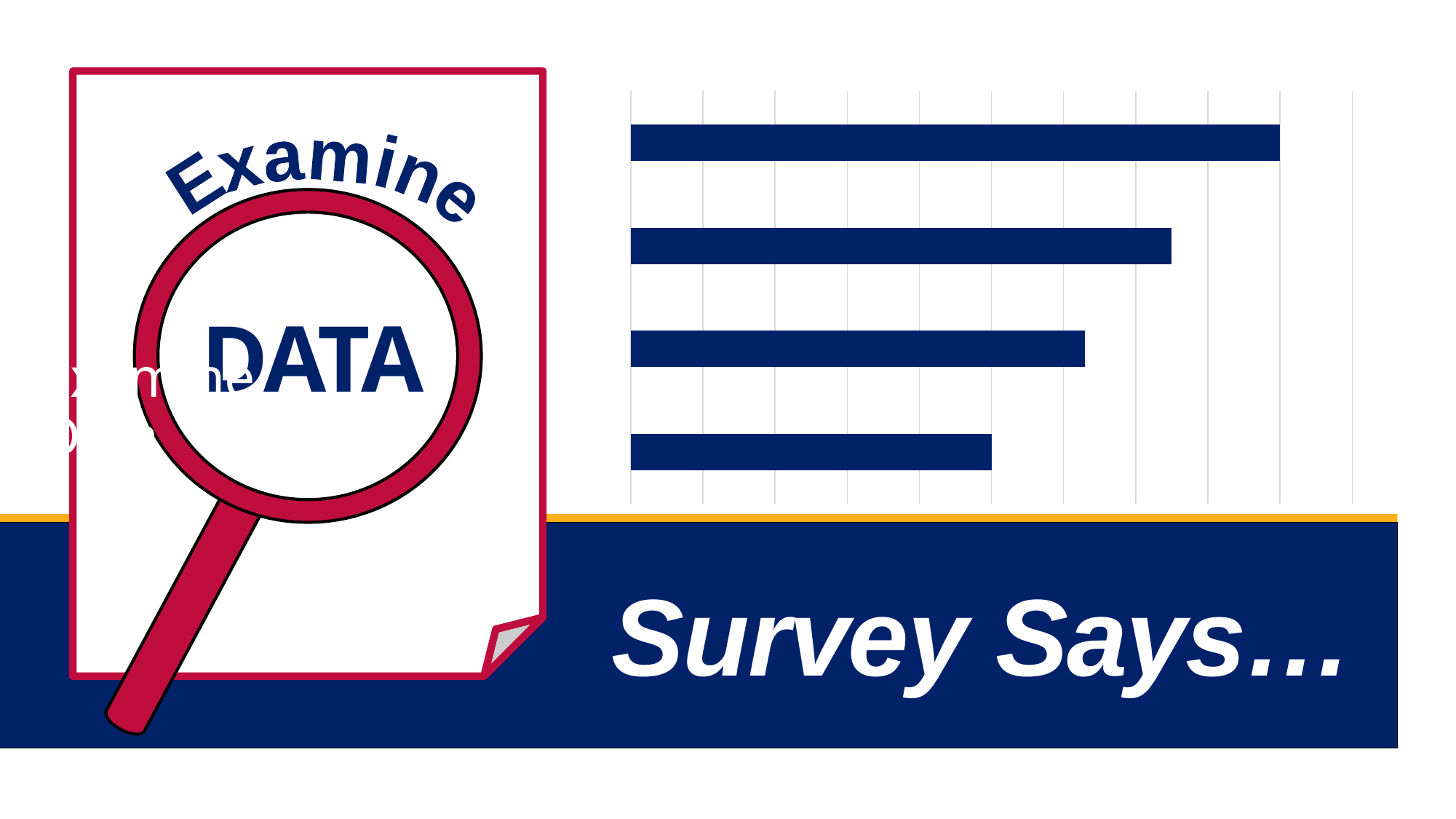
What colour are the bars in the chart? dark blue Are the bars in the chart oriented horizontally or vertically? horizontally Which bar in the chart is the shortest: the top, second, third, or bottom bar? the bottom bar Which bar in the chart is the longest: the top, second, third, or bottom bar? the top bar Do the bar lengths increase or decrease going from the top bar to the bottom bar? decrease Is the second bar from the top longer or shorter than the third bar from the top? longer What kind of chart is shown on the right side of the slide? bar chart Is the bottom bar longer or shorter than the top bar? shorter How many bars does the chart on the right side of the slide have? 4